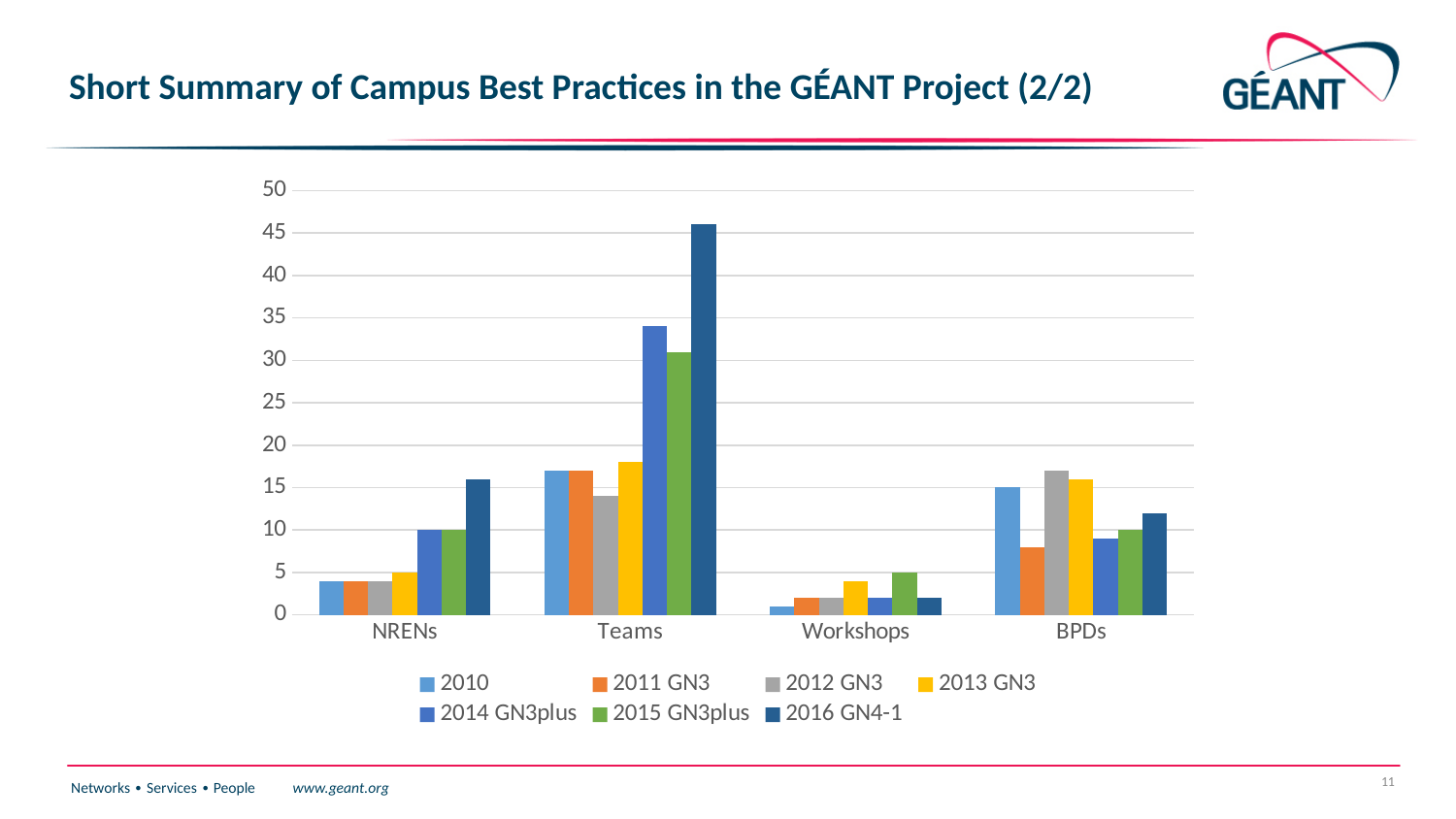
How many categories are shown on the x axis of the chart? 4 What kind of chart is shown on the slide? bar chart How many series does the chart's legend list? 7 Is the value for Teams in 2016 GN4-1 greater or less than 40? greater Which category has the lowest values overall in the chart? Workshops Is the value for Teams in 2014 GN3plus greater or less than 30? greater Is the value for BPDs in 2016 GN4-1 greater or less than 15? less For BPDs, which is larger: the 2011 GN3 bar or the 2012 GN3 bar? 2012 GN3 What is the highest value shown on the chart's y axis? 50 For Teams, which is larger: the 2014 GN3plus bar or the 2015 GN3plus bar? 2014 GN3plus Which category has the tallest bar in the chart? Teams